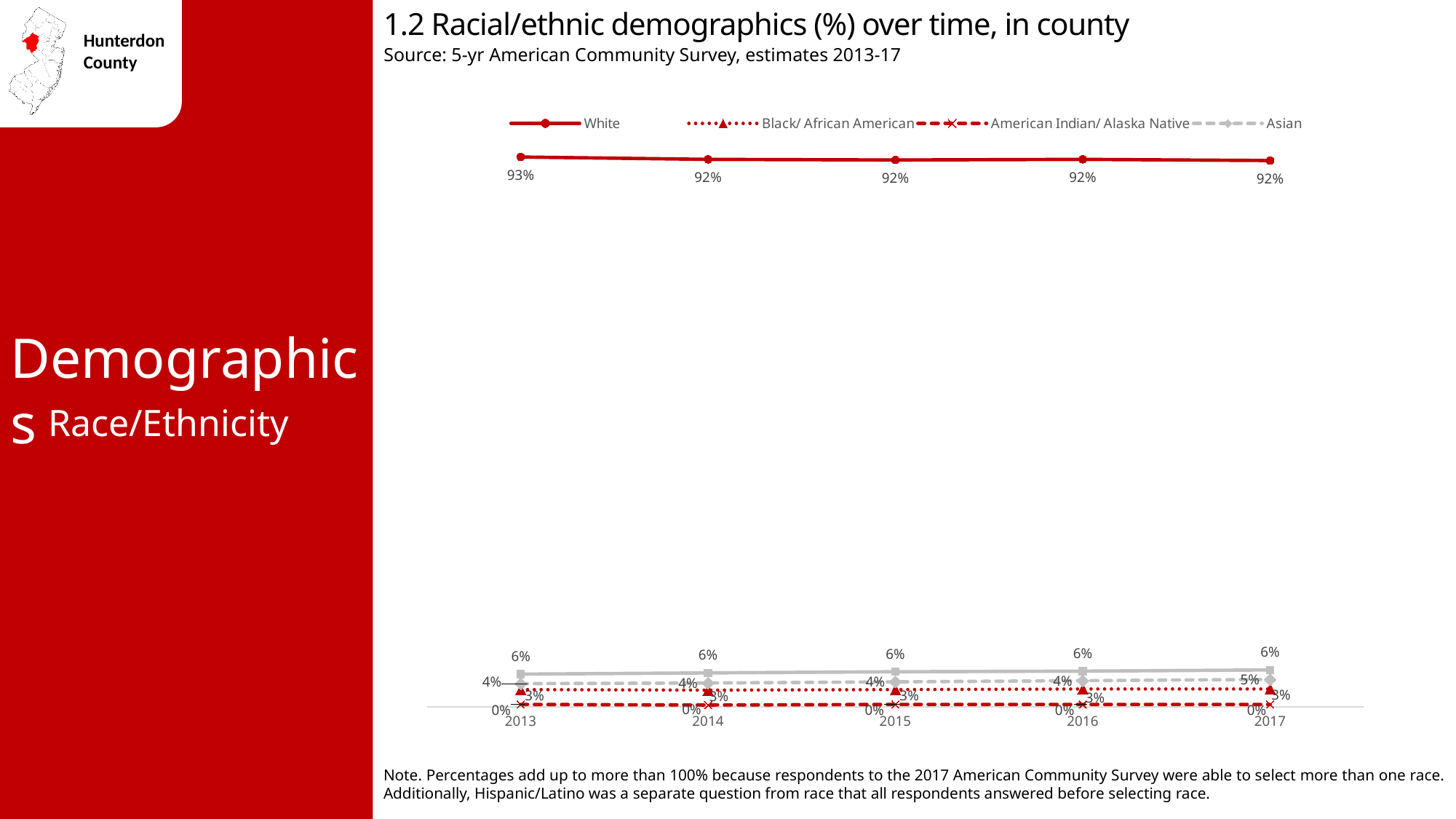
What is the title of the chart? 1.2 Racial/ethnic demographics (%) over time, in county Which racial/ethnic group has the highest percentage in 2013? White What percentage is shown for White in 2013? 93% By how many percentage points did the White share change from 2013 to 2017? 1 percentage point What percentage is shown for Asian in 2017? 5% How many years are plotted along the x axis? 5 What percentage is shown for White in 2017? 92% What kind of chart is shown on the slide? line chart Which racial/ethnic group has the lowest percentage in 2016? American Indian/ Alaska Native How many series does the legend list? 4 What percentage is shown for Black/ African American in 2014? 3% What percentage is shown for American Indian/ Alaska Native in 2015? 0%